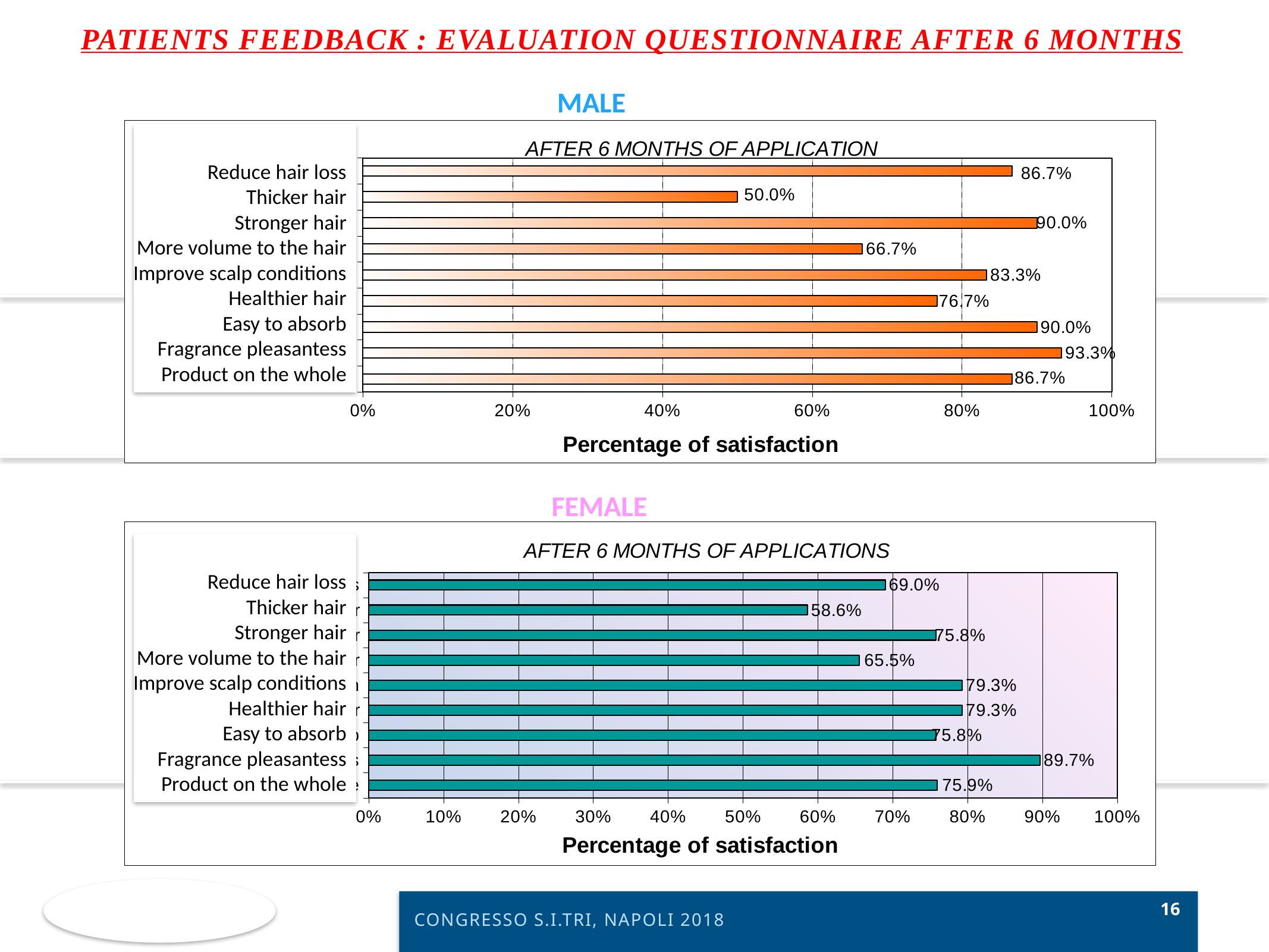
In the MALE chart, how many categories are shown? 9 In the MALE chart, which category has the lowest percentage of satisfaction? Thicker hair In the FEMALE chart, which is larger: Reduce hair loss or More volume to the hair? Reduce hair loss In the FEMALE chart, what is the difference between Fragrance pleasantess and Reduce hair loss? 20.7% In the MALE chart, what is the difference between Fragrance pleasantess and Thicker hair? 43.3% In the FEMALE chart, what is the percentage of satisfaction for Fragrance pleasantess? 89.7% In the MALE chart, which category has the highest percentage of satisfaction? Fragrance pleasantess In the MALE chart, what is the percentage of satisfaction for Thicker hair? 50.0% In the FEMALE chart, what is the percentage of satisfaction for Product on the whole? 75.9% What kind of chart is the FEMALE chart? Bar chart What is the x-axis title of the MALE chart? Percentage of satisfaction In the FEMALE chart, which category has the lowest percentage of satisfaction? Thicker hair